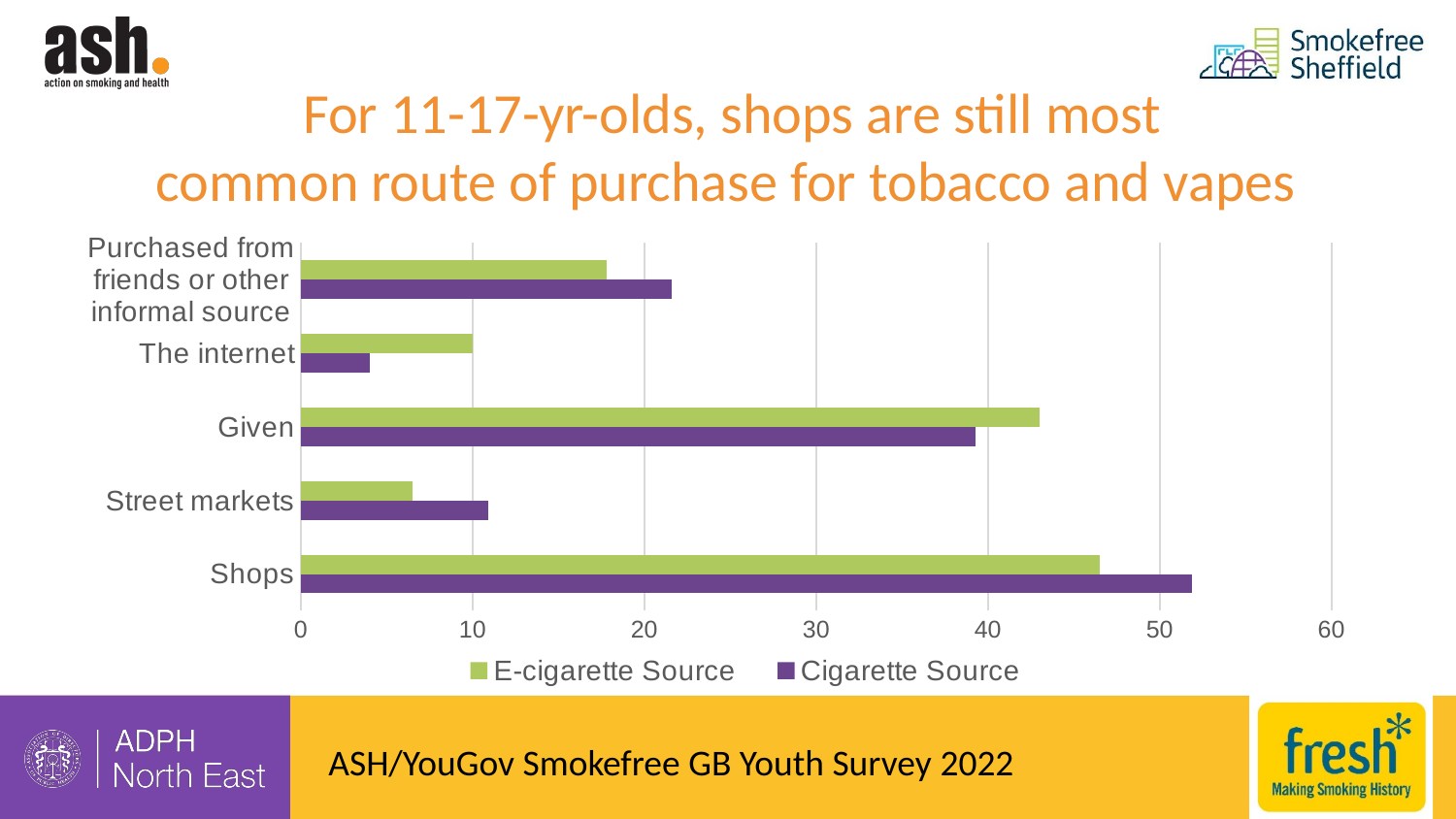
Is the E-cigarette Source value for Given greater or less than 40? greater How many categories are shown on the chart? 5 Which category has the highest value for Cigarette Source? Shops Which category has the highest value for E-cigarette Source? Shops For Shops, which is larger: the E-cigarette Source value or the Cigarette Source value? Cigarette Source Which series is shown in purple in the legend? Cigarette Source For The internet, which is larger: the E-cigarette Source value or the Cigarette Source value? E-cigarette Source Which category has the lowest value for Cigarette Source? The internet How many series does the legend list? 2 Is the Cigarette Source value for Shops greater or less than 50? greater Which category has the lowest value for E-cigarette Source? Street markets What kind of chart is shown on the slide? bar chart